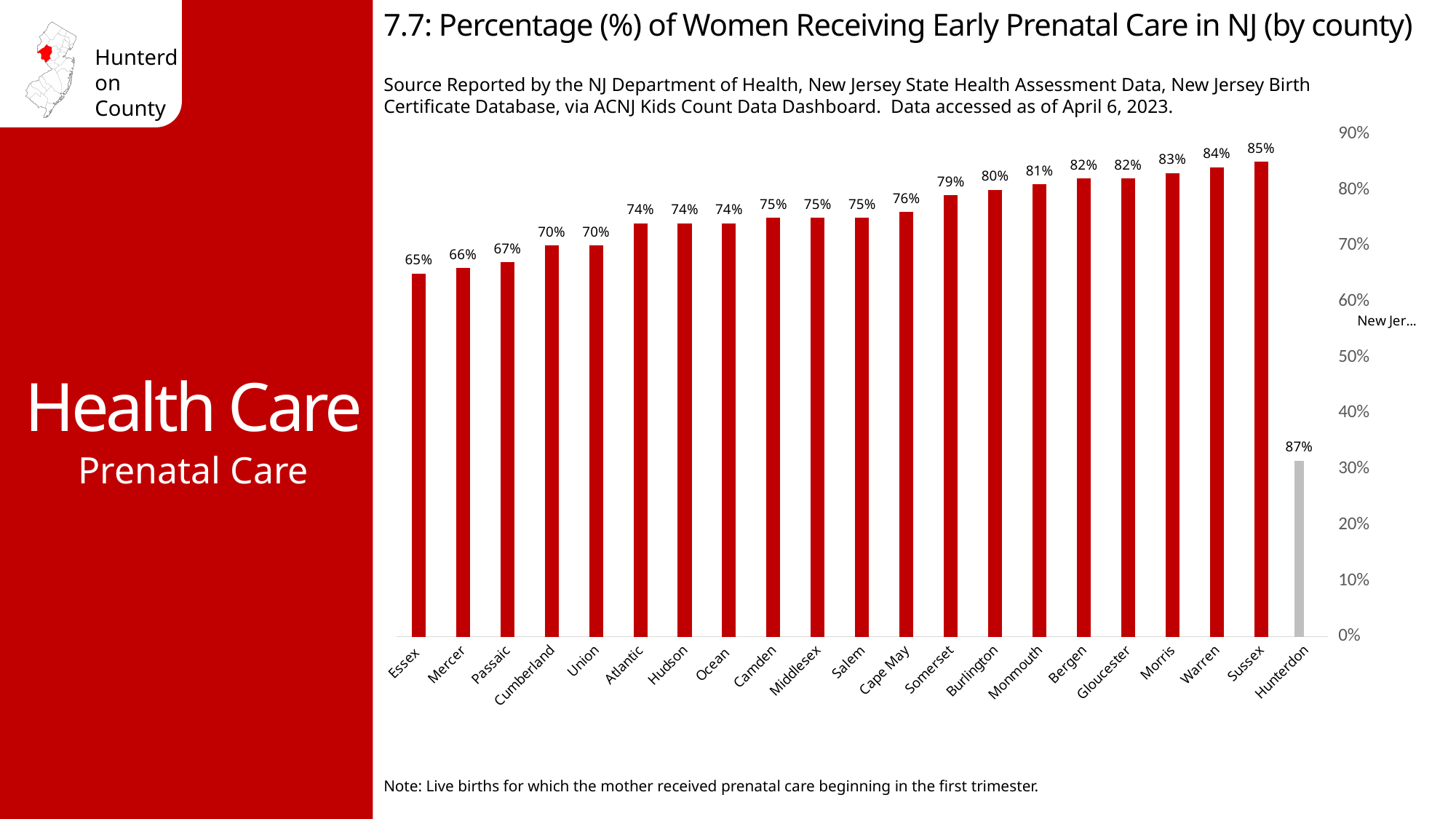
What is the value for Somerset? 79% Which county's bar is coloured gray instead of red? Hunterdon Which is larger, the value for Morris or the value for Cape May? Morris Which county has the lowest percentage of women receiving early prenatal care? Essex What percentage of women received early prenatal care in Bergen county? 82% Is the value for Union greater or less than 60%? greater What is the difference between the values for Sussex and Essex? 20 percentage points What is the difference between the values for Warren and Burlington? 4 percentage points How many counties are shown on the x axis? 21 Do the values generally rise or fall from Essex to Sussex along the x axis? Rise What kind of chart is shown on the slide? Bar chart What is the value shown for Cumberland? 70%